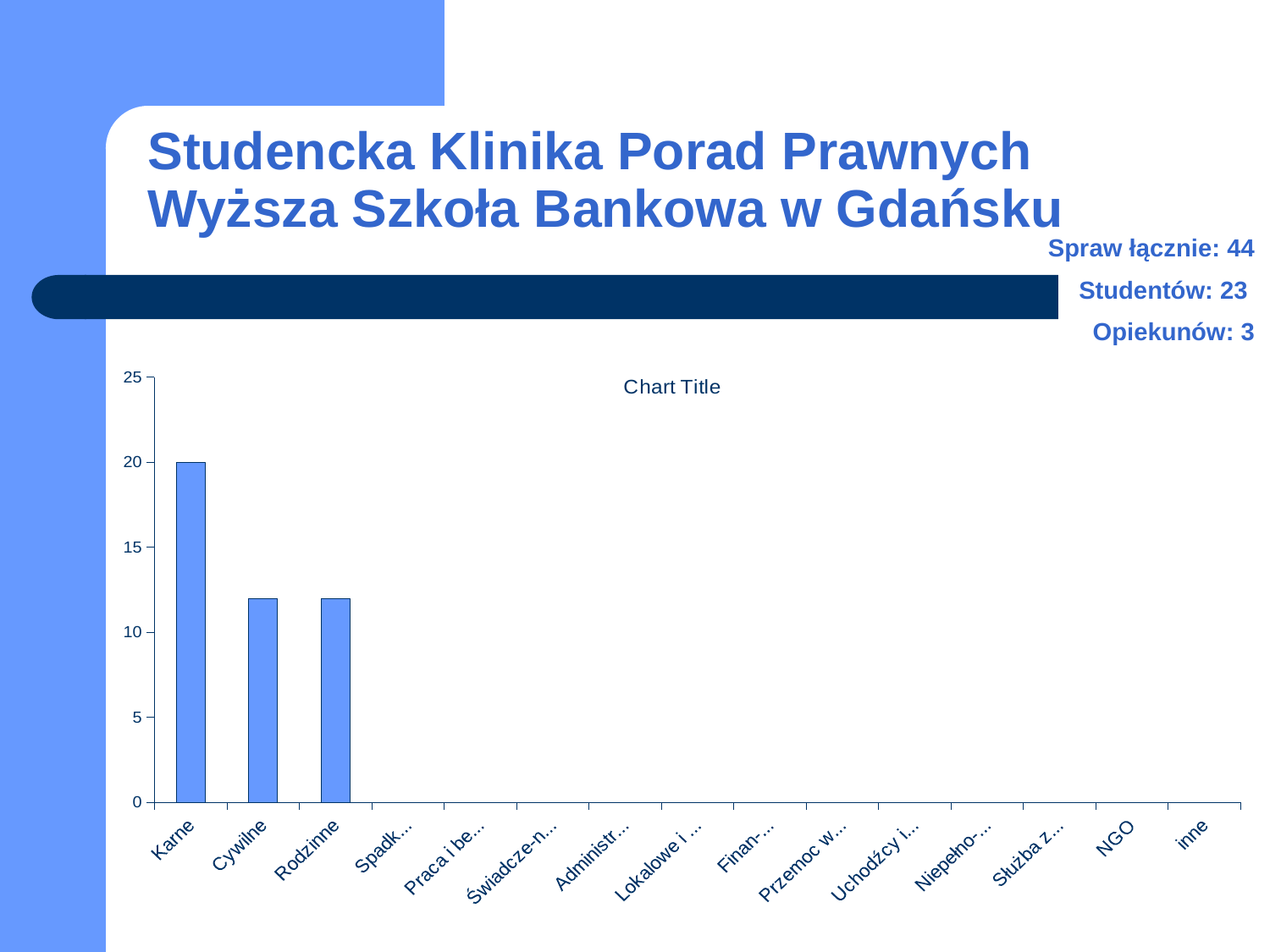
How many categories are shown on the x axis? 15 How many categories have a visible bar above zero? 3 What is the title of the chart? Chart Title Is the value for Rodzinne greater or less than 15? less Which category has the highest value? Karne Is the value for Cywilne greater or less than 10? greater Is the value for Karne greater or less than 15? greater What is the value for Karne? 20 Which is larger, the value for Karne or the value for Cywilne? Karne Which is larger, the value for Karne or the value for Rodzinne? Karne What kind of chart is shown on the slide? bar chart